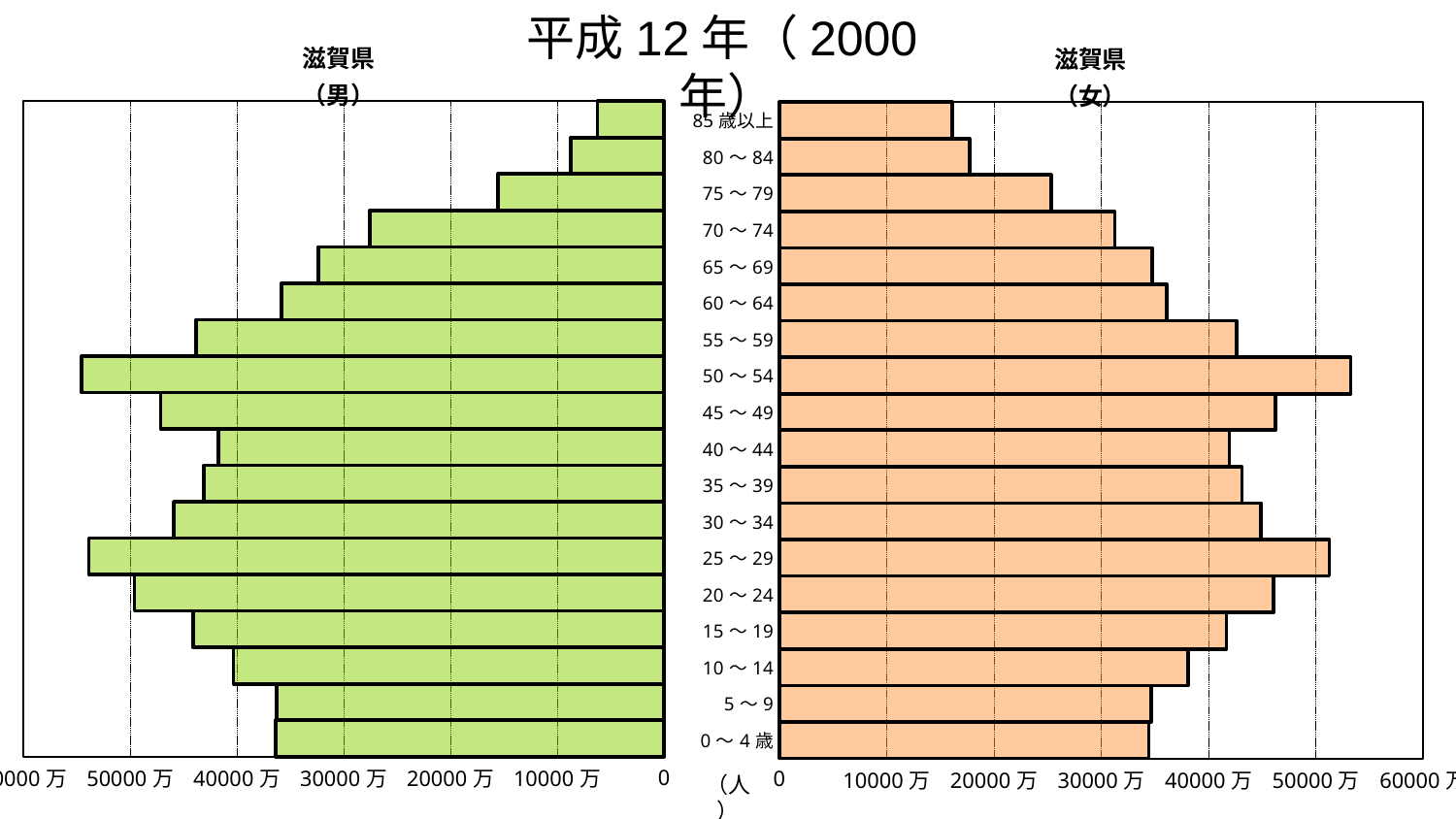
In the 滋賀県（男） chart, which age group has the lowest value? 85歳以上 In the 滋賀県（女） chart, which is larger, the value for 50～54 or the value for 0～4歳? 50～54 In the 滋賀県（男） chart, which is larger, the value for 0～4歳 or the value for 85歳以上? 0～4歳 In the 滋賀県（女） chart, is the value for 85歳以上 greater or less than 10000万? greater How many age groups are plotted in the 滋賀県（男） chart? 18 In the 滋賀県（男） chart, is the value for 85歳以上 greater or less than 10000万? less In the 滋賀県（女） chart, is the value for 75～79 greater or less than 20000万? greater What kind of chart is shown on the slide? bar chart What is the title shown at the top of the slide? 平成12年（2000年）